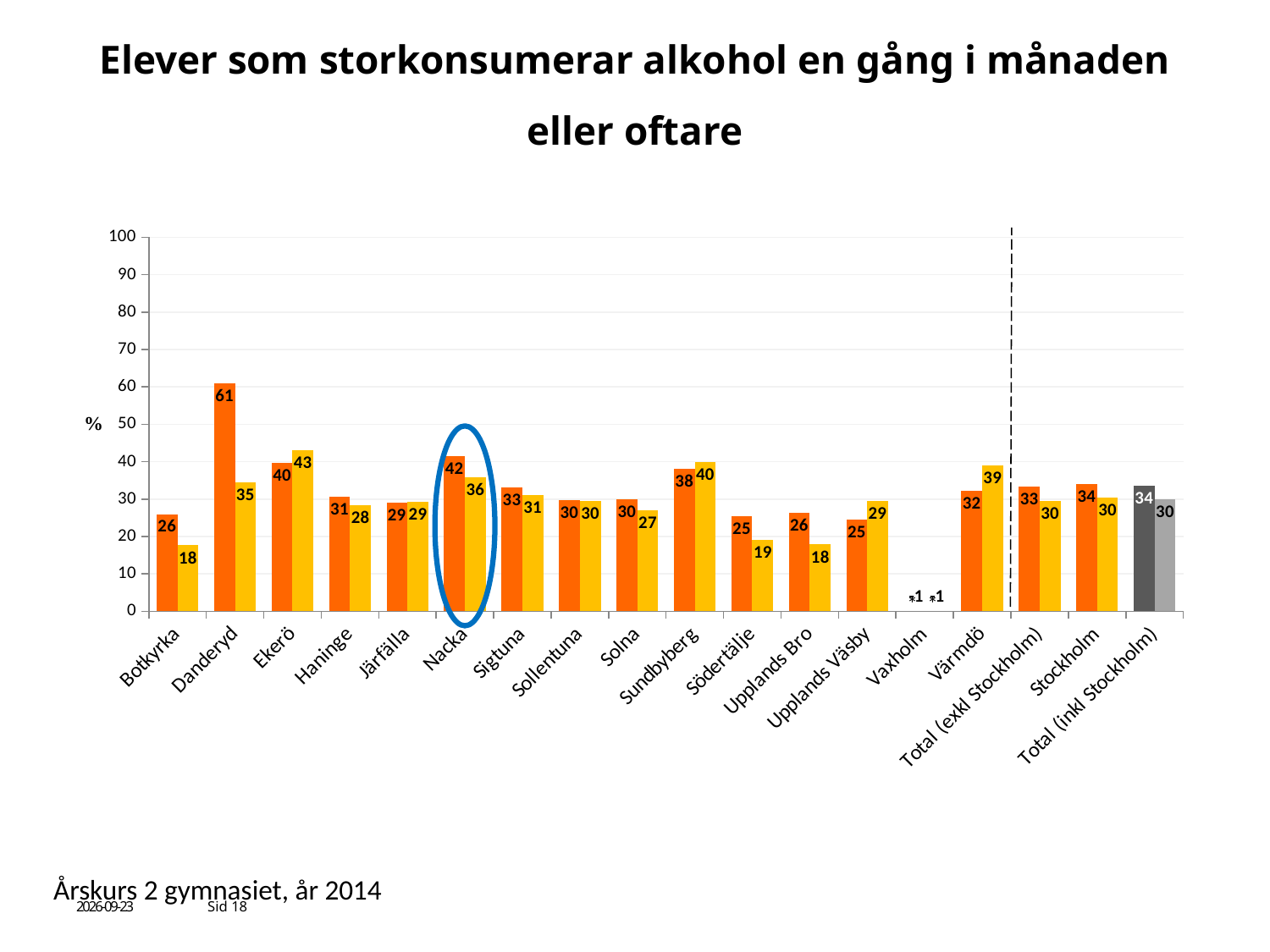
What is the value of the orange bar for Nacka, the category circled in blue? 42 What is the value of the yellow bar for Värmdö? 39 How many categories are shown on the x axis? 18 Which municipality has the lowest yellow bar among those with a numeric label? Botkyrka and Upplands Bro (both 18) What kind of chart is shown on the slide? bar chart Is the orange bar for Danderyd greater or less than 50? greater What is the value of the orange bar for Danderyd? 61 What is the value of the yellow bar for Botkyrka? 18 What is the title of the chart? Elever som storkonsumerar alkohol en gång i månaden eller oftare What is the difference between the orange and yellow bars for Danderyd? 26 For Ekerö, which is larger, the orange bar or the yellow bar? the yellow bar (43) Which municipality has the highest orange bar? Danderyd